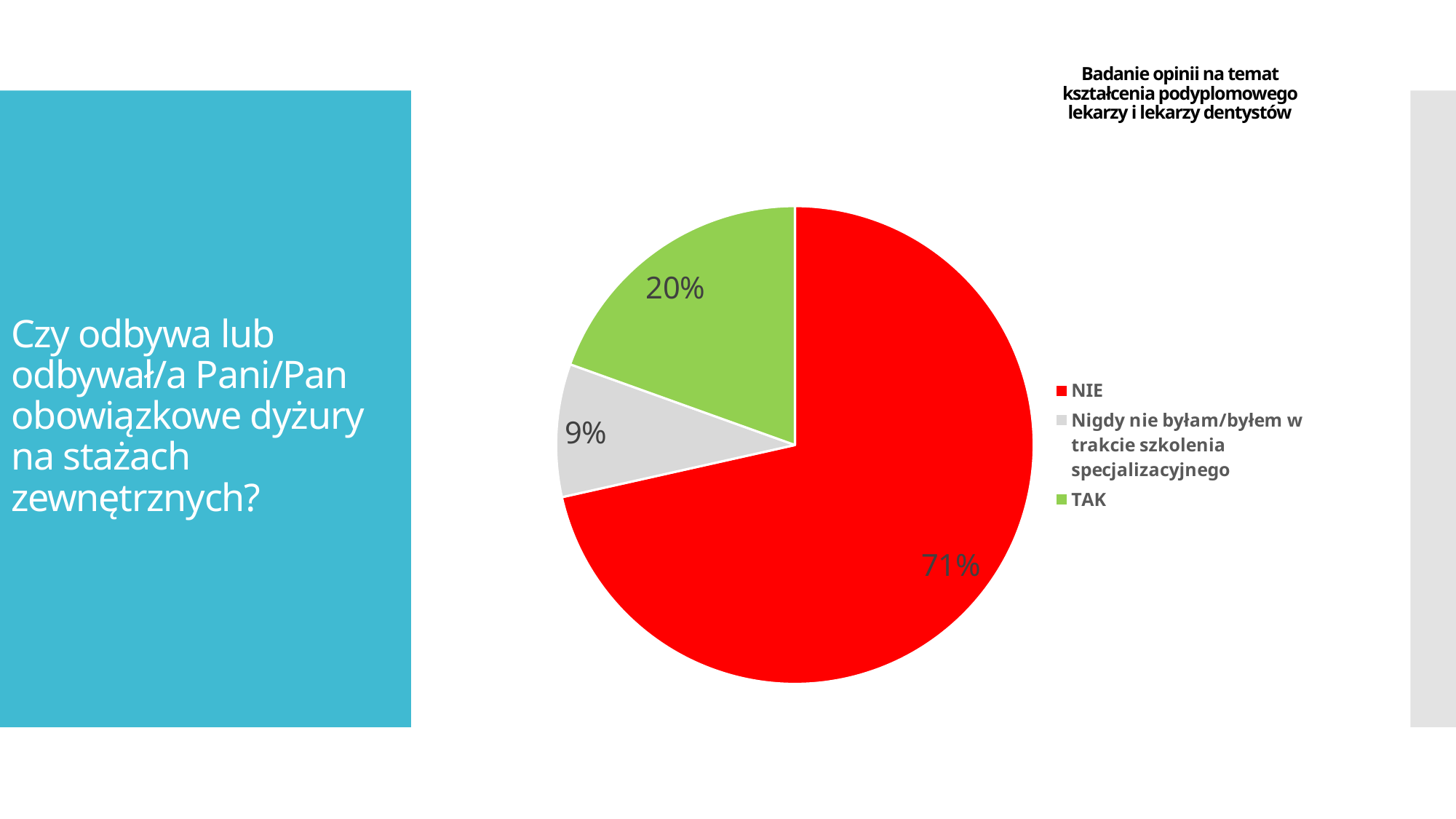
What kind of chart is shown on the slide? Pie chart How many slices does the pie chart have? 3 Which category has the largest slice of the pie? NIE What is the difference in percentage points between the NIE slice and the TAK slice? 51 What share of the pie does the NIE slice represent? 71% Which category has the smallest slice of the pie? Nigdy nie byłam/byłem w trakcie szkolenia specjalizacyjnego What colour is the TAK slice in the pie chart? Green How many entries does the legend list? 3 What share of the pie does the TAK slice represent? 20% What share of the pie does the slice 'Nigdy nie byłam/byłem w trakcie szkolenia specjalizacyjnego' represent? 9% Which slice is larger, TAK or NIE? NIE What is the difference in percentage points between the TAK slice and the 'Nigdy nie byłam/byłem w trakcie szkolenia specjalizacyjnego' slice? 11